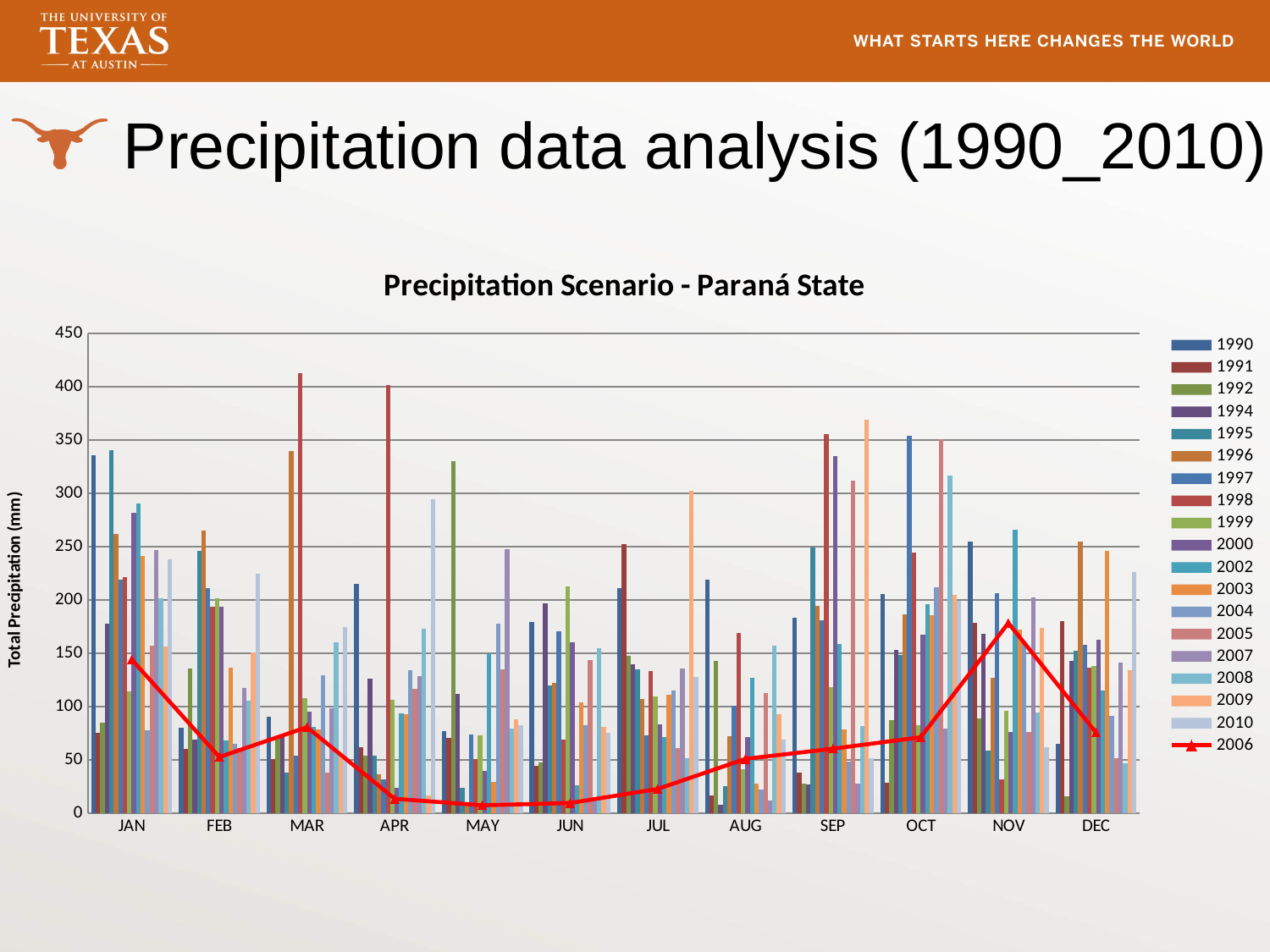
Is the value of the 2006 line for NOV greater or less than 150? greater How many months are shown along the x axis? 12 Is the value of the 2006 line for JAN greater or less than 100? greater What is the label on the vertical axis of the chart? Total Precipitation (mm) Is the value of the 2006 line for MAY greater or less than 50? less What kind of chart is shown on the slide? A bar chart with a line series What is the title of the chart? Precipitation Scenario - Paraná State How many series does the chart legend list? 19 Does the 2006 line rise or fall from JAN to MAY? fall In which month does the 2006 line reach its highest value? NOV Which is larger for the 2006 line: the value for NOV or the value for FEB? NOV